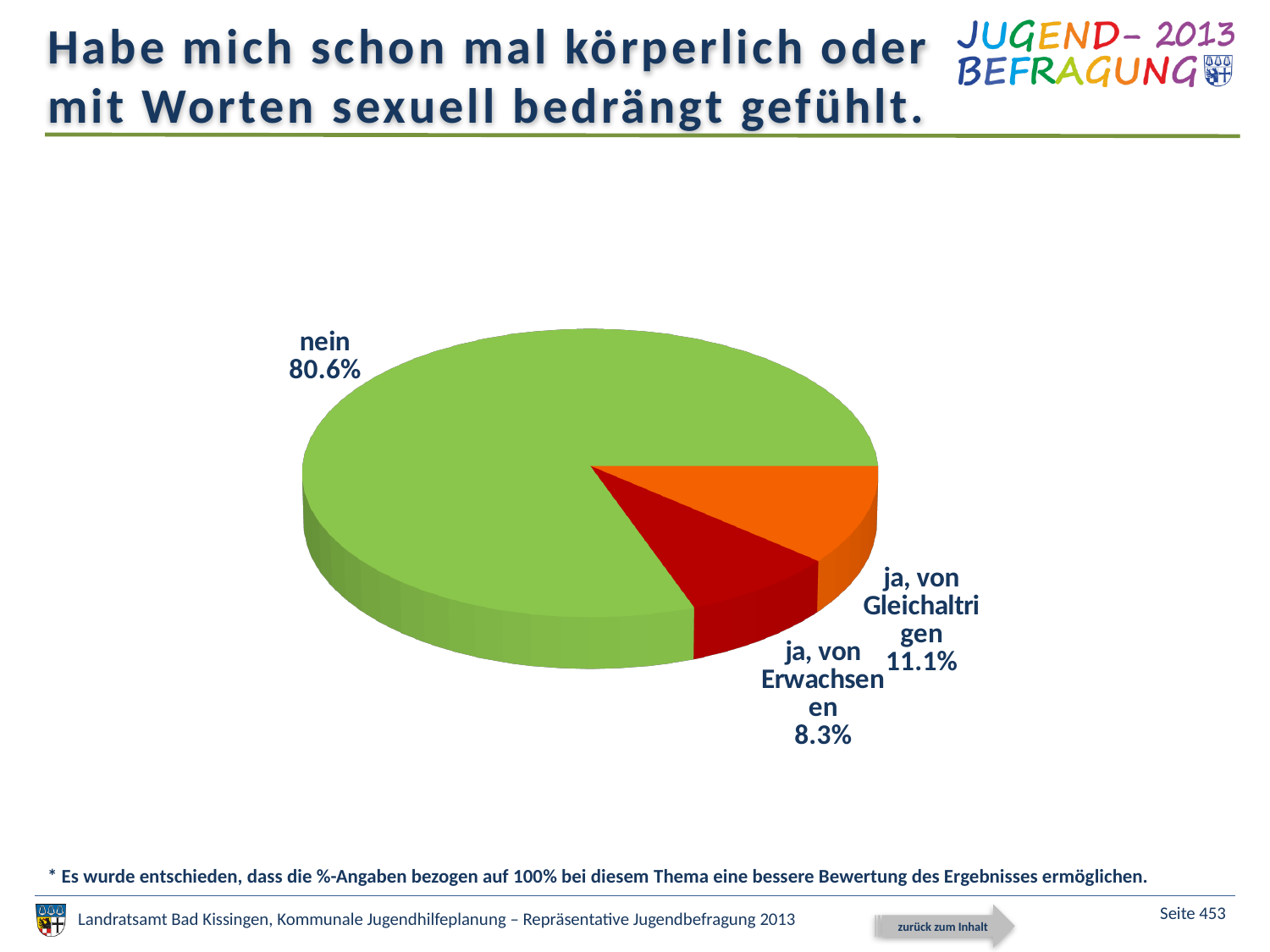
What colour is the "nein" slice of the pie? green Which slice of the pie is the smallest? ja, von Erwachsenen What is the difference in percentage points between the "ja, von Gleichaltrigen" slice and the "ja, von Erwachsenen" slice? 2.8 What percentage is shown for the "ja, von Gleichaltrigen" slice? 11.1% What is the difference in percentage points between the "nein" slice and the "ja, von Gleichaltrigen" slice? 69.5 Which slice of the pie is the largest? nein Which is larger: the "ja, von Gleichaltrigen" slice or the "ja, von Erwachsenen" slice? ja, von Gleichaltrigen What colour is the "ja, von Erwachsenen" slice of the pie? red What kind of chart is shown on the slide? pie chart How many slices does the pie chart have? 3 What percentage is shown for the "ja, von Erwachsenen" slice? 8.3% What percentage is shown for the "nein" slice? 80.6%